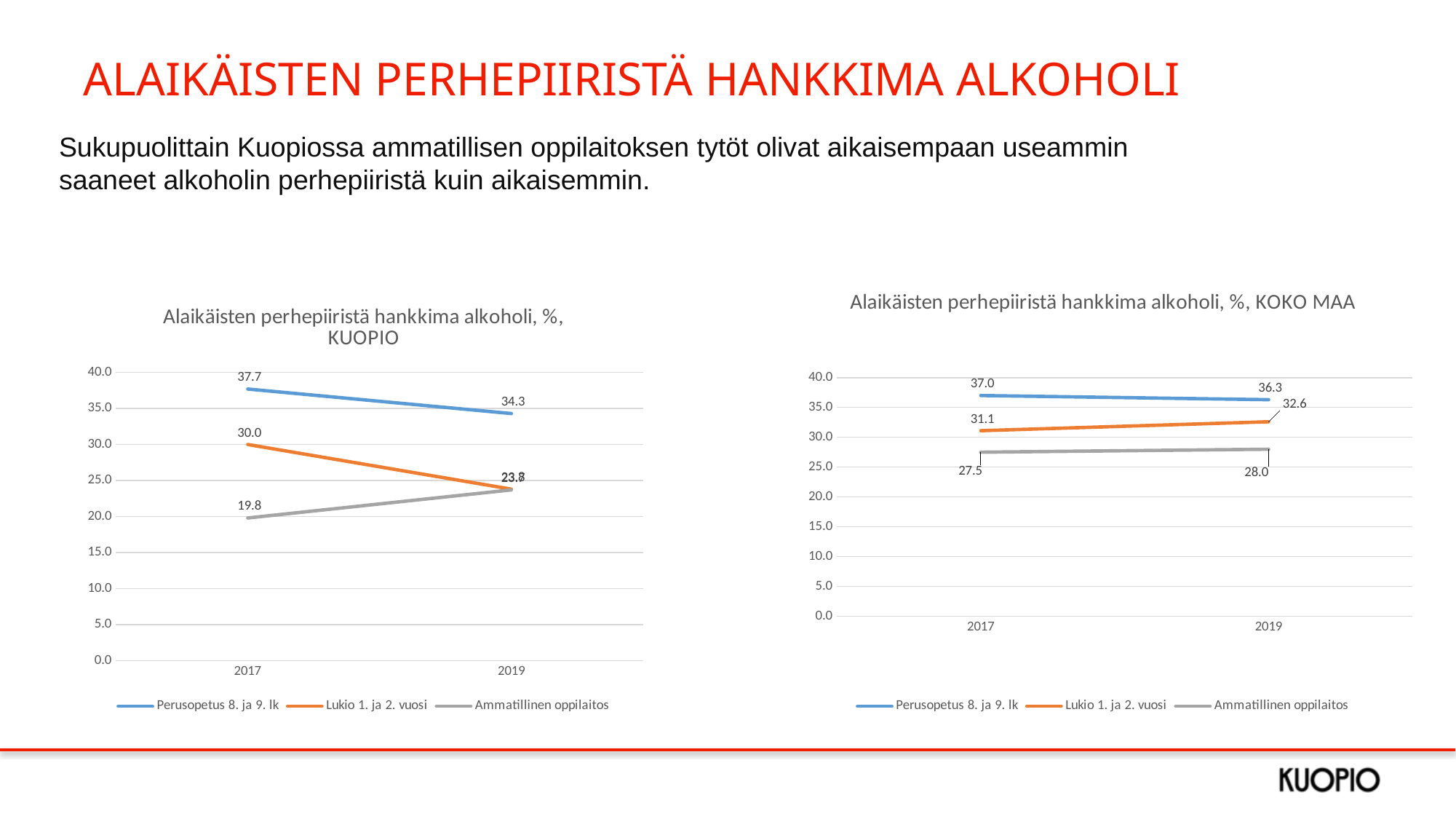
In the KUOPIO chart, what is the value for Perusopetus 8. ja 9. lk in 2019? 34.3 In the KOKO MAA chart, what is the difference between Perusopetus 8. ja 9. lk and Ammatillinen oppilaitos in 2019? 8.3 In the KOKO MAA chart, what is the value for Ammatillinen oppilaitos in 2017? 27.5 In the KOKO MAA chart, which series has the highest value in 2017? Perusopetus 8. ja 9. lk In the KUOPIO chart, does the value for Lukio 1. ja 2. vuosi rise or fall from 2017 to 2019? fall How many series does the legend of the KOKO MAA chart list? 3 In the KOKO MAA chart, what is the value for Lukio 1. ja 2. vuosi in 2019? 32.6 In the KUOPIO chart, what is the value for Perusopetus 8. ja 9. lk in 2017? 37.7 In the KUOPIO chart, what is the value for Ammatillinen oppilaitos in 2017? 19.8 In the KUOPIO chart, what is the value for Lukio 1. ja 2. vuosi in 2017? 30.0 In the KUOPIO chart, by how much did the value for Perusopetus 8. ja 9. lk change from 2017 to 2019? 3.4 What type of chart is the KUOPIO chart? line chart